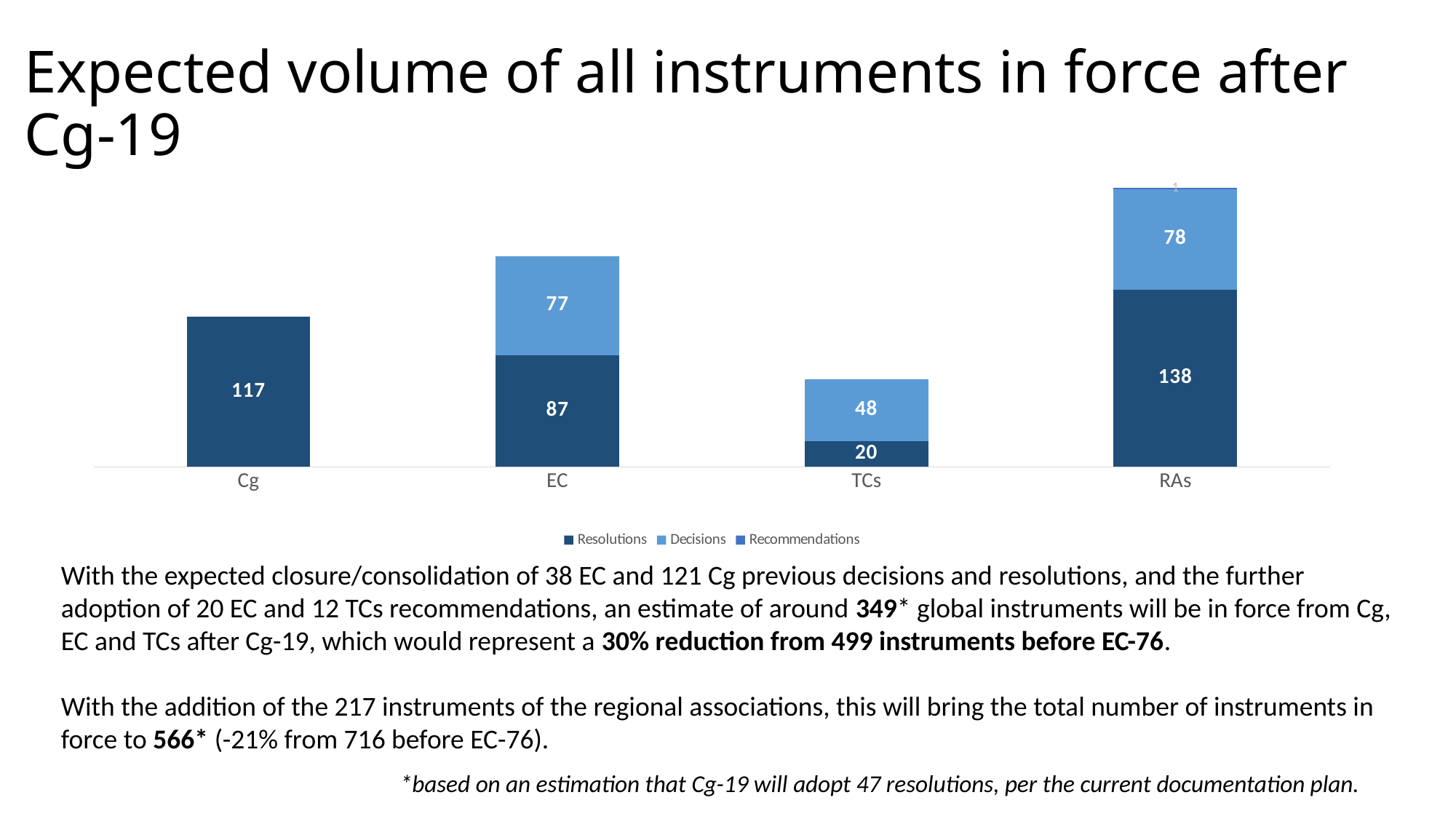
Which category has the lowest Resolutions value? TCs Which is larger, the Decisions value for EC or the Decisions value for TCs? EC What is the Resolutions value for Cg? 117 What is the Resolutions value for RAs? 138 What is the difference between the Resolutions values for RAs and Cg? 21 How many series does the chart legend list? 3 What is the Decisions value for EC? 77 How many categories are shown on the x axis of the chart? 4 What is the Resolutions value for TCs? 20 Which category has the highest Resolutions value? RAs What type of chart is shown on the slide? Stacked bar chart What is the total of the stacked bar for TCs? 68